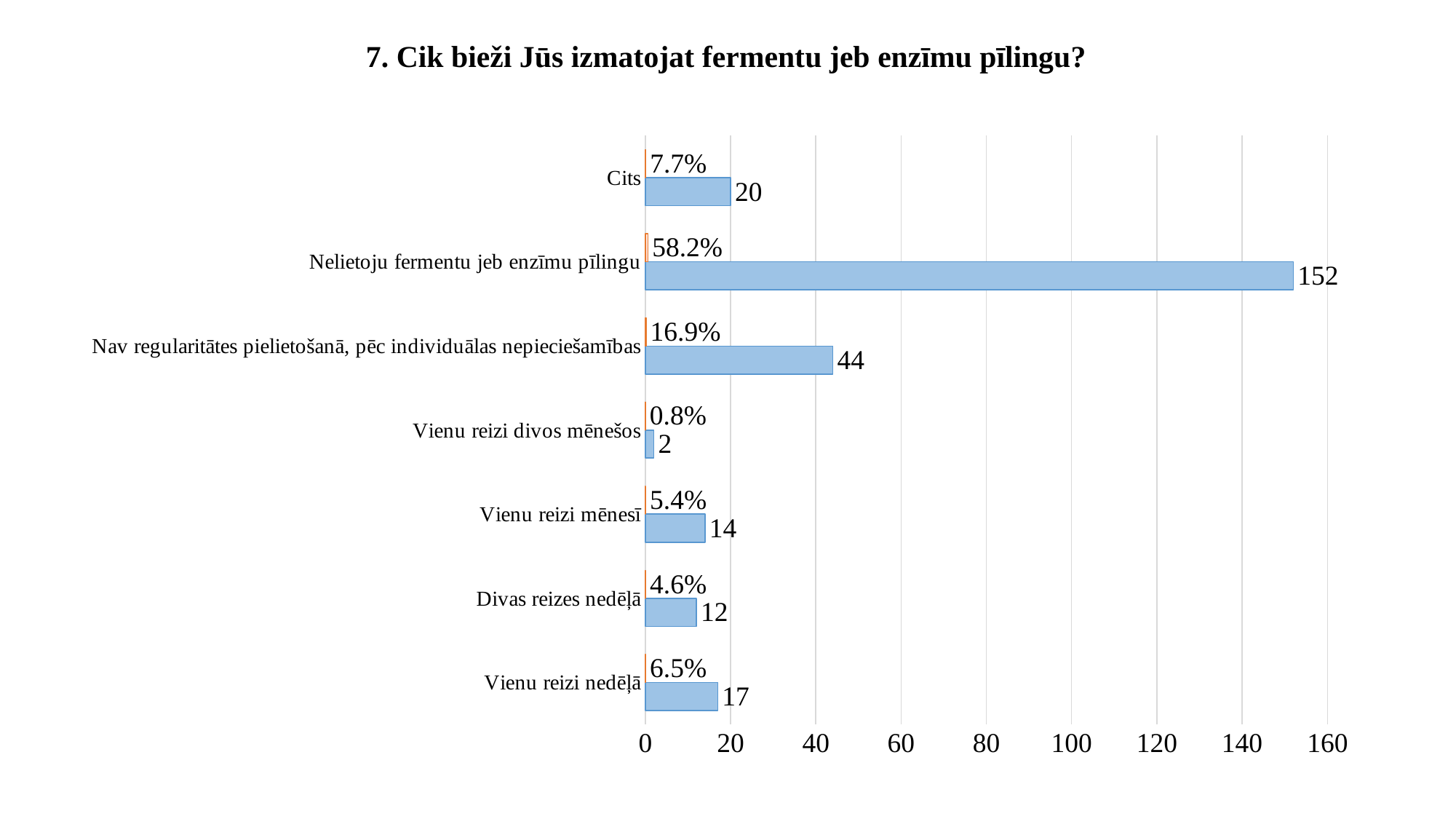
What is the difference between the counts for "Nelietoju fermentu jeb enzīmu pīlingu" and "Nav regularitātes pielietošanā, pēc individuālas nepieciešamības"? 108 Is the count for "Nav regularitātes pielietošanā, pēc individuālas nepieciešamības" greater or less than 40? greater What is the count value for "Nelietoju fermentu jeb enzīmu pīlingu"? 152 What kind of chart is shown on the slide? bar chart How many categories are shown on the chart? 7 What is the count value for "Vienu reizi nedēļā"? 17 What percentage is shown for "Nav regularitātes pielietošanā, pēc individuālas nepieciešamības"? 16.9% What percentage is shown for "Cits"? 7.7% What is the title of the chart? 7. Cik bieži Jūs izmatojat fermentu jeb enzīmu pīlingu? Which category has the lowest count? Vienu reizi divos mēnešos Which category has the highest count? Nelietoju fermentu jeb enzīmu pīlingu Which has a larger count, "Vienu reizi mēnesī" or "Divas reizes nedēļā"? Vienu reizi mēnesī